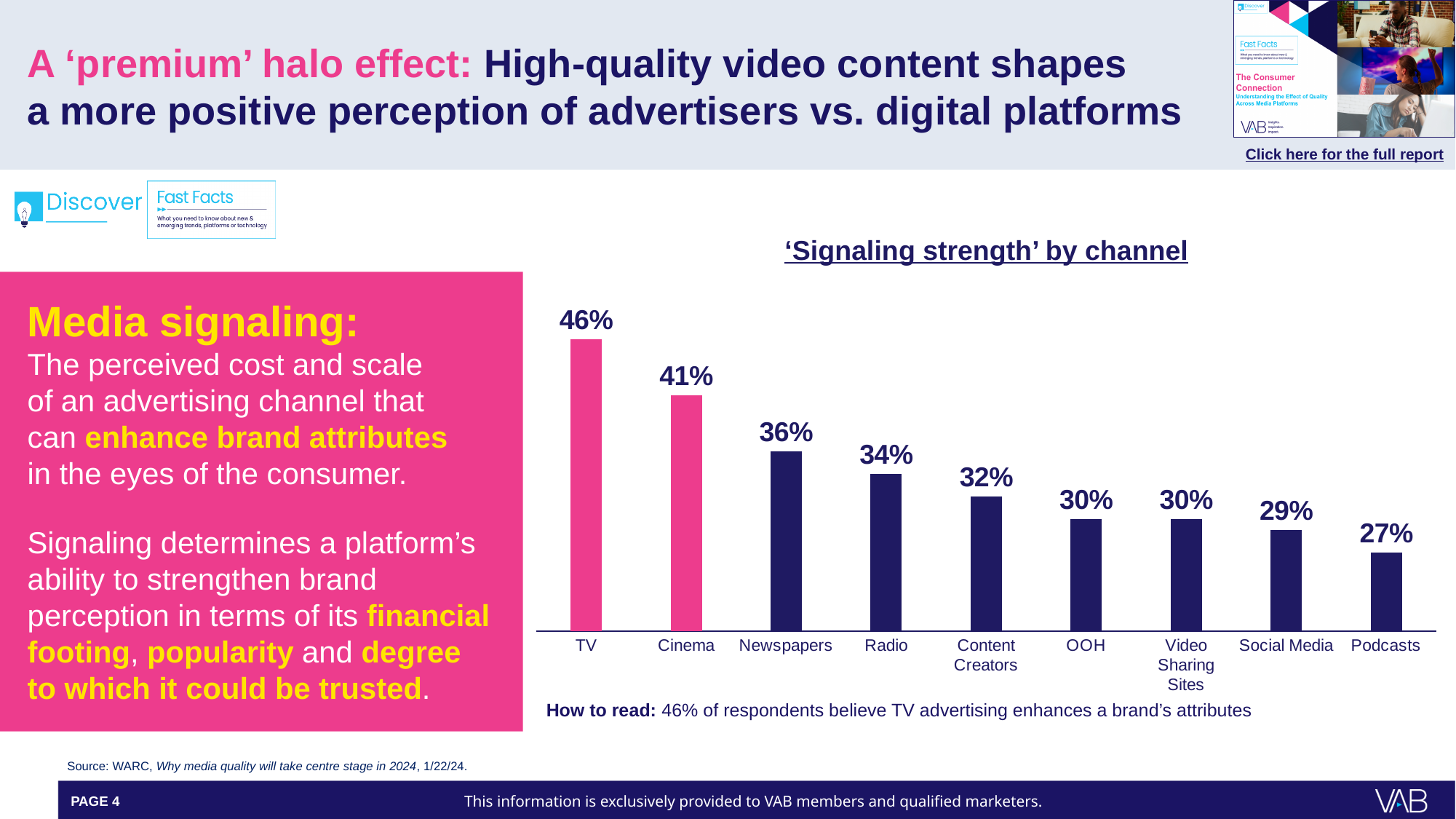
Do the values rise or fall moving from left to right across the channels? Fall What is the signaling strength value for Newspapers? 36% Which has a higher signaling strength, Cinema or Radio? Cinema What is the signaling strength value for Podcasts? 27% What is the difference between the signaling strength of TV and Cinema? 5% What is the difference between the signaling strength of Radio and Social Media? 5% What is the signaling strength value for TV? 46% What kind of chart is used to show signaling strength by channel? Bar chart Which channel has the lowest signaling strength? Podcasts What is the signaling strength value for Content Creators? 32% Which channel has the highest signaling strength? TV How many channels are shown in the chart? 9